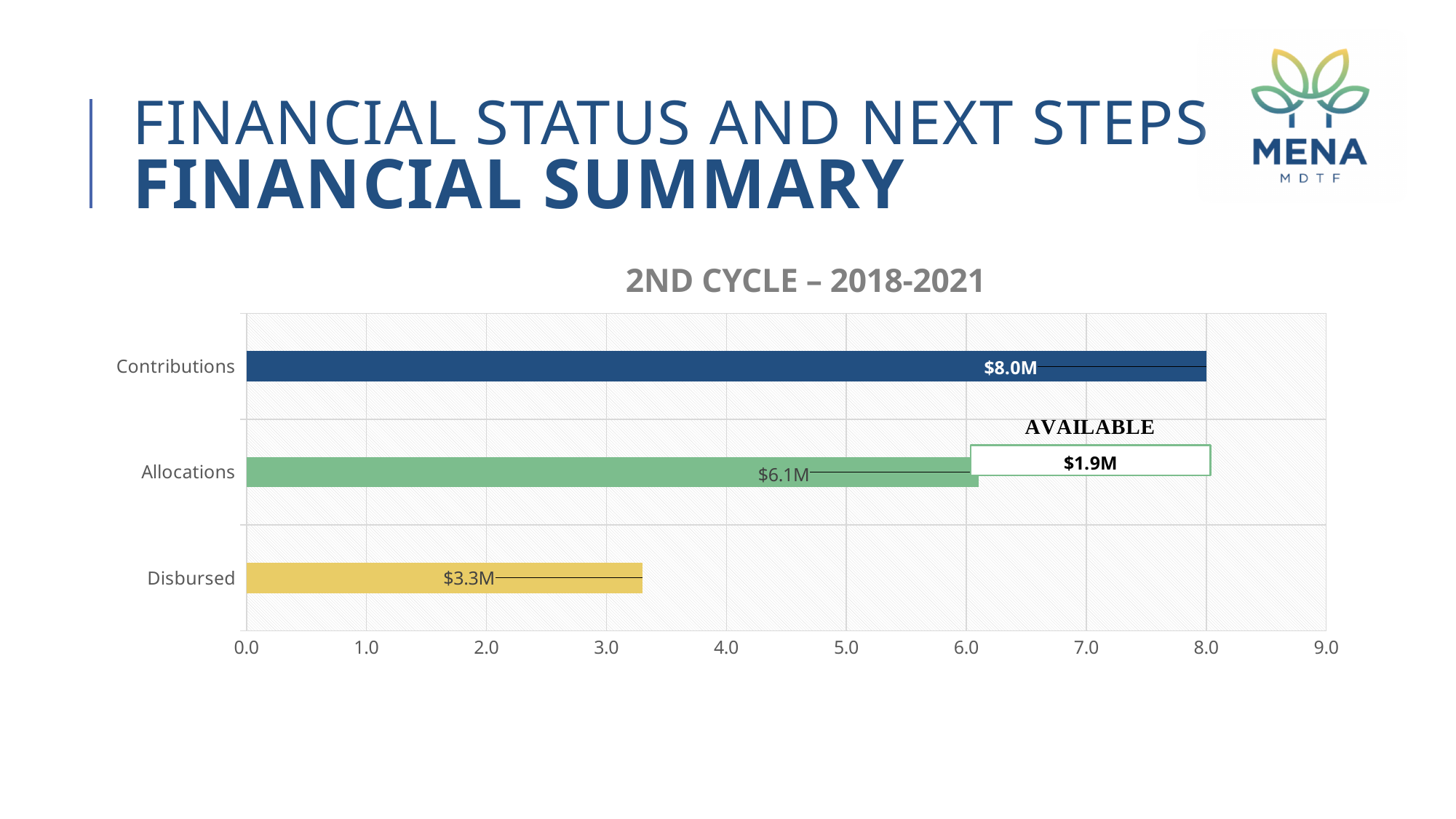
What is the difference between Allocations and Disbursed? $2.8M Which category has the highest value? Contributions Which is larger, Allocations or Disbursed? Allocations Is the value for Disbursed greater or less than 4.0? less What is the difference between Contributions and Allocations? $1.9M What kind of chart is shown on the slide? bar chart What is the value for Allocations? $6.1M What is the title of the chart? 2ND CYCLE – 2018-2021 What is the value for Contributions? $8.0M Which category has the lowest value? Disbursed How many categories are shown in the chart? 3 What is the value for Disbursed? $3.3M